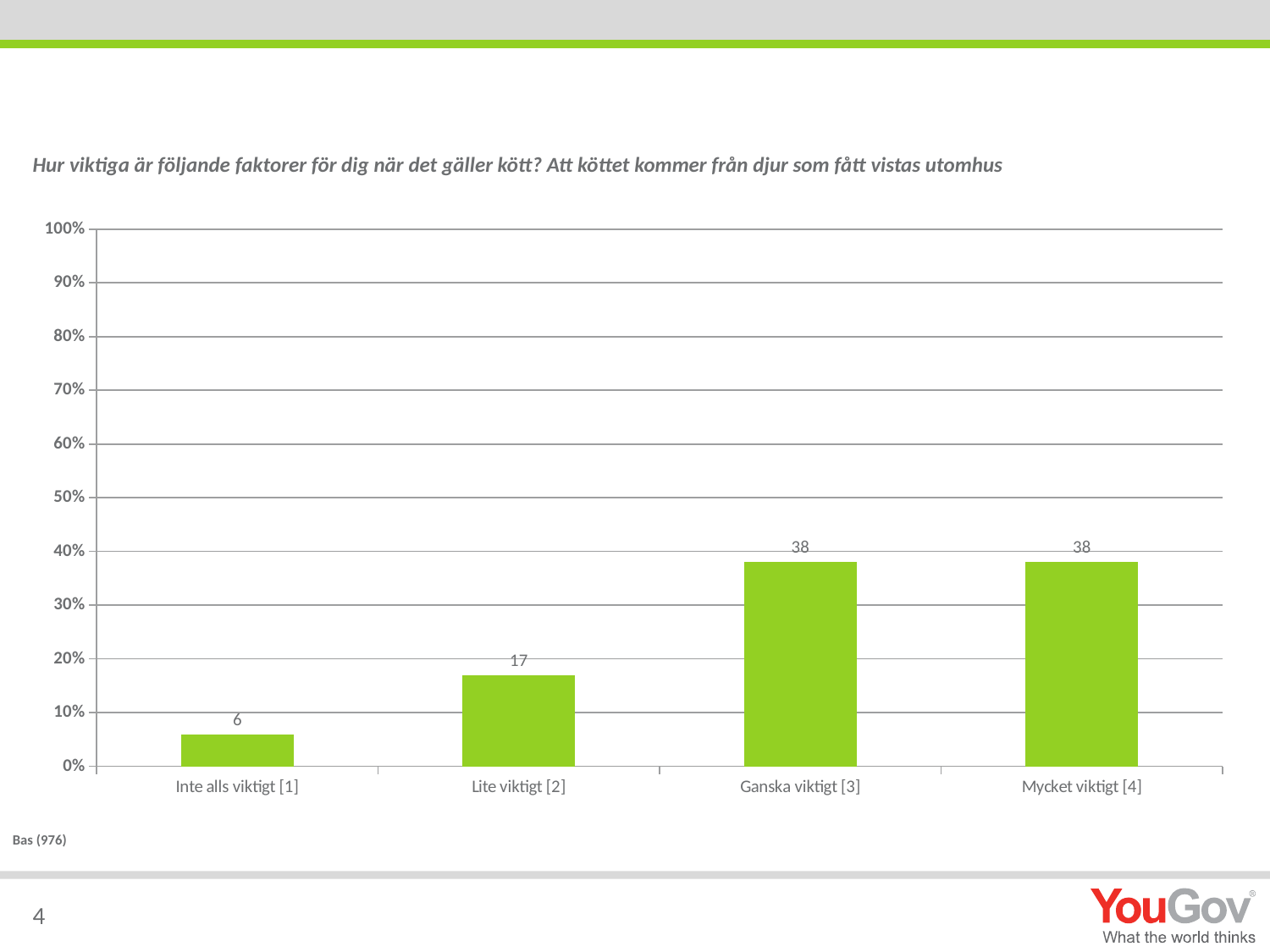
What is the value for "Lite viktigt [2]"? 17 What is the value for "Inte alls viktigt [1]"? 6 What kind of chart is shown on the slide? bar chart What is the difference between the values for "Lite viktigt [2]" and "Inte alls viktigt [1]"? 11 What is the value for "Ganska viktigt [3]"? 38 How many categories are shown on the x axis? 4 Which category has the lowest value? Inte alls viktigt [1] Is the value for "Ganska viktigt [3]" greater or less than 30%? greater Which is larger, the value for "Lite viktigt [2]" or the value for "Inte alls viktigt [1]"? Lite viktigt [2] What is the value for "Mycket viktigt [4]"? 38 What is the base (Bas) shown below the chart? 976 What is the difference between the values for "Ganska viktigt [3]" and "Lite viktigt [2]"? 21